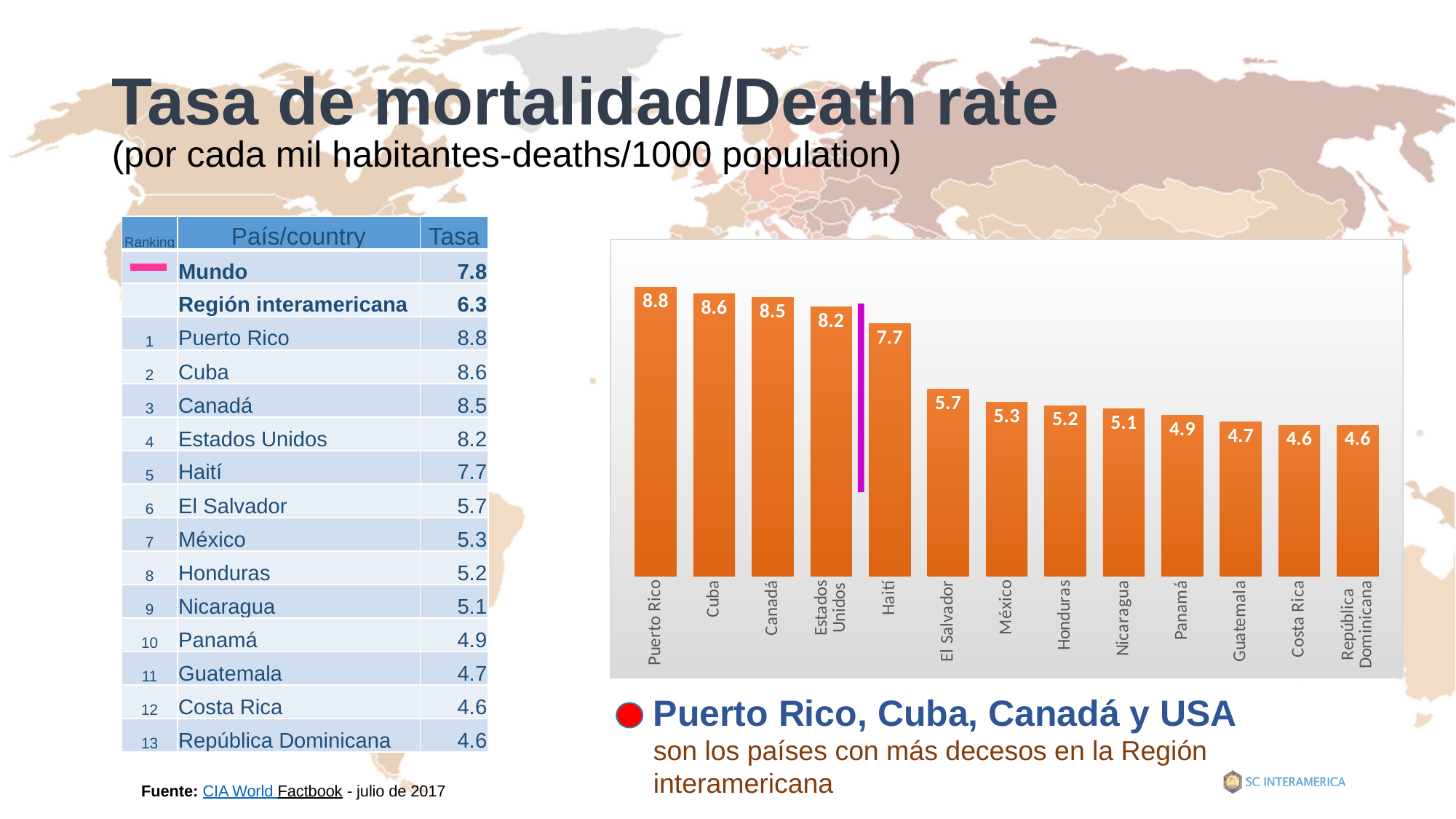
Which country has the lowest value in the bar chart, excluding ties? Name the two countries tied for the lowest value. Costa Rica and República Dominicana Which country has the highest bar in the chart? Puerto Rico Do the values in the bar chart rise or fall from left to right? Fall What is the death rate value shown for Puerto Rico in the bar chart? 8.8 What is the value shown for Haití in the bar chart? 7.7 What is the difference between the values for Puerto Rico and Cuba in the bar chart? 0.2 What type of chart is shown on the slide? Bar chart Which has a higher value in the bar chart, México or Panamá? México What is the difference between the values for Haití and El Salvador in the bar chart? 2.0 How many countries are shown as bars in the chart? 13 What is the value shown for Nicaragua in the bar chart? 5.1 Which has a higher value in the bar chart, Canadá or Estados Unidos? Canadá